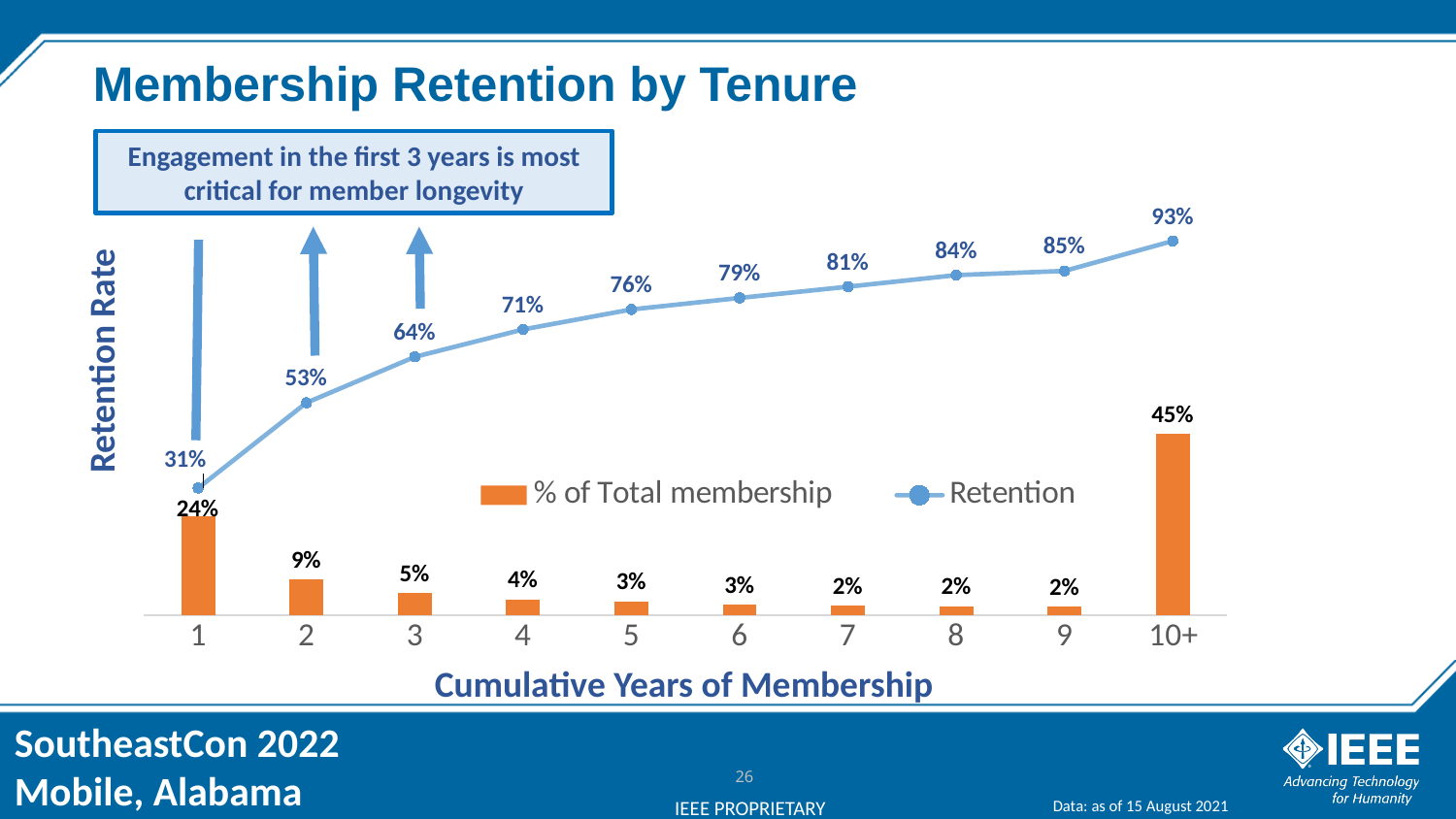
What is the label of the x axis? Cumulative Years of Membership Which cumulative years category has the highest retention rate? 10+ How many series does the legend list? 2 Which is larger: the % of total membership at 1 year or at 10+ years? 10+ years What is the difference between the retention rate at 2 years and at 1 year? 22% What is the retention rate for members with 1 cumulative year of membership? 31% What is the retention rate at 5 cumulative years of membership? 76% What is the title of the chart? Membership Retention by Tenure Which cumulative years category has the lowest retention rate? 1 Does the retention rate rise or fall as cumulative years of membership increase? rise How many cumulative years categories are shown on the x axis? 10 What percentage of total membership has 10+ cumulative years of membership? 45%